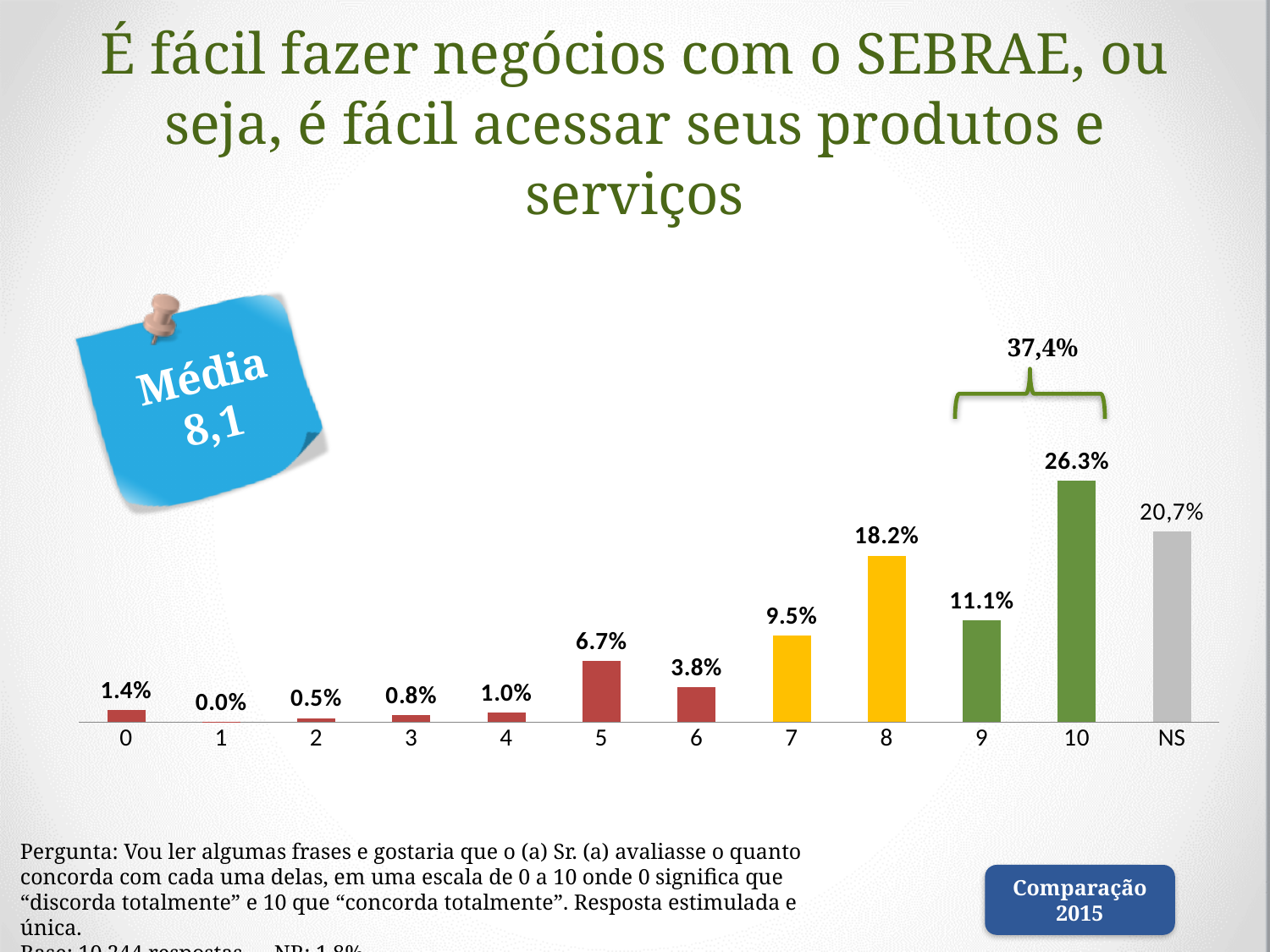
What is the difference between the percentages for scores 10 and 9? 15.2% What average (Média) is shown on the sticky note? 8,1 Which has a larger percentage, score 5 or score 6? 5 Which score category has the lowest percentage? 1 What is the value shown for the NS category? 20,7% What percentage of respondents gave a score of 10? 26.3% What colour are the bars for scores 7 and 8? Yellow What is the combined percentage for scores 9 and 10, as shown by the bracket above them? 37,4% What kind of chart is shown on the slide? Bar chart What percentage of respondents gave a score of 8? 18.2% Which score category has the highest percentage? 10 How many categories are shown on the x axis? 12